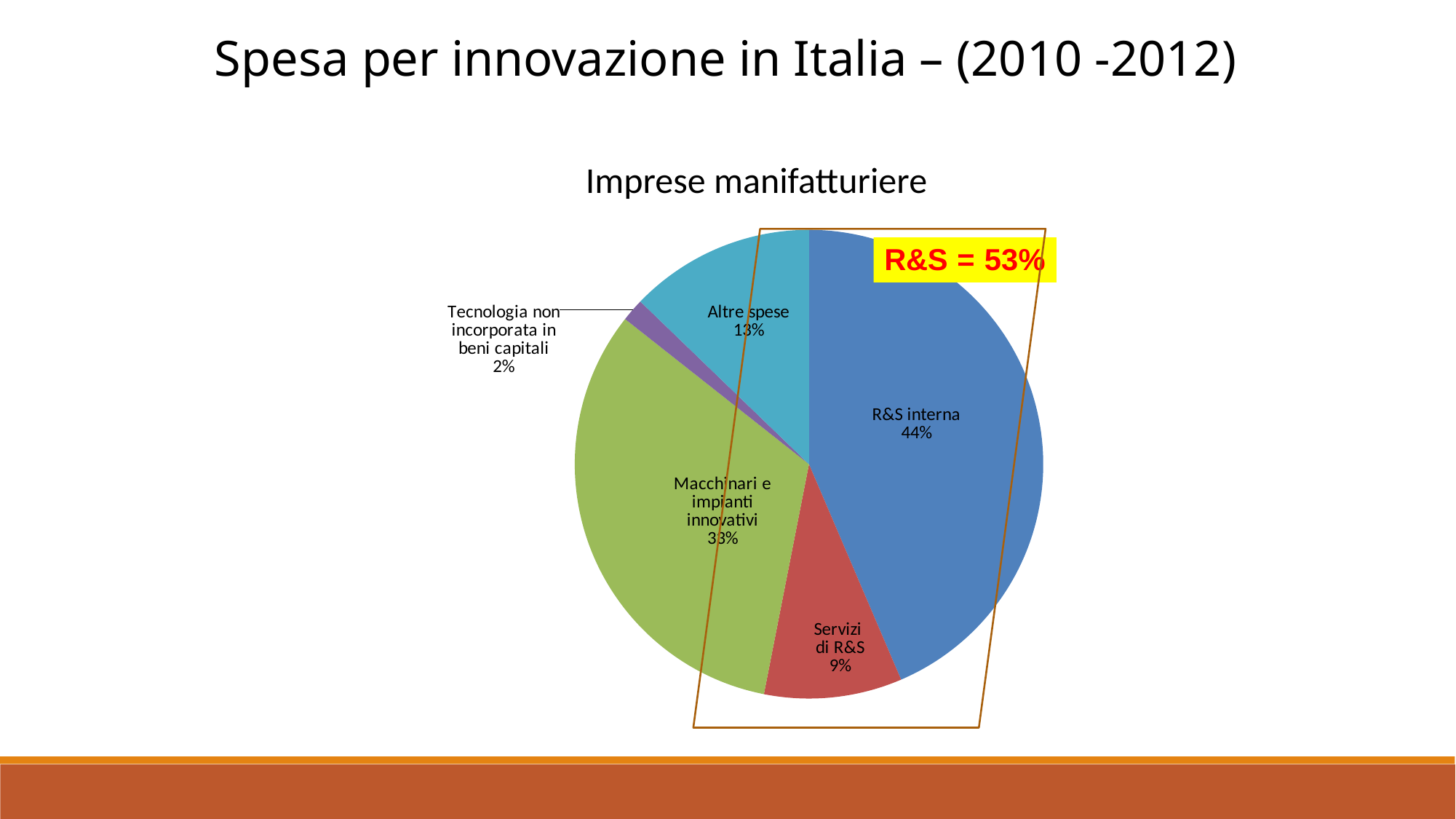
What share of the pie is Tecnologia non incorporata in beni capitali? 2% What is the title of the chart? Imprese manifatturiere How many slices does the pie chart have? 5 What share of the pie is Altre spese? 13% Which is larger, Altre spese or Servizi di R&S? Altre spese What share of the pie is Macchinari e impianti innovativi? 33% What share of the pie is R&S interna? 44% What is the difference between the shares of R&S interna and Macchinari e impianti innovativi? 11% What kind of chart is shown on the slide? pie chart What share of the pie is Servizi di R&S? 9% Which slice is the largest? R&S interna Which slice is the smallest? Tecnologia non incorporata in beni capitali